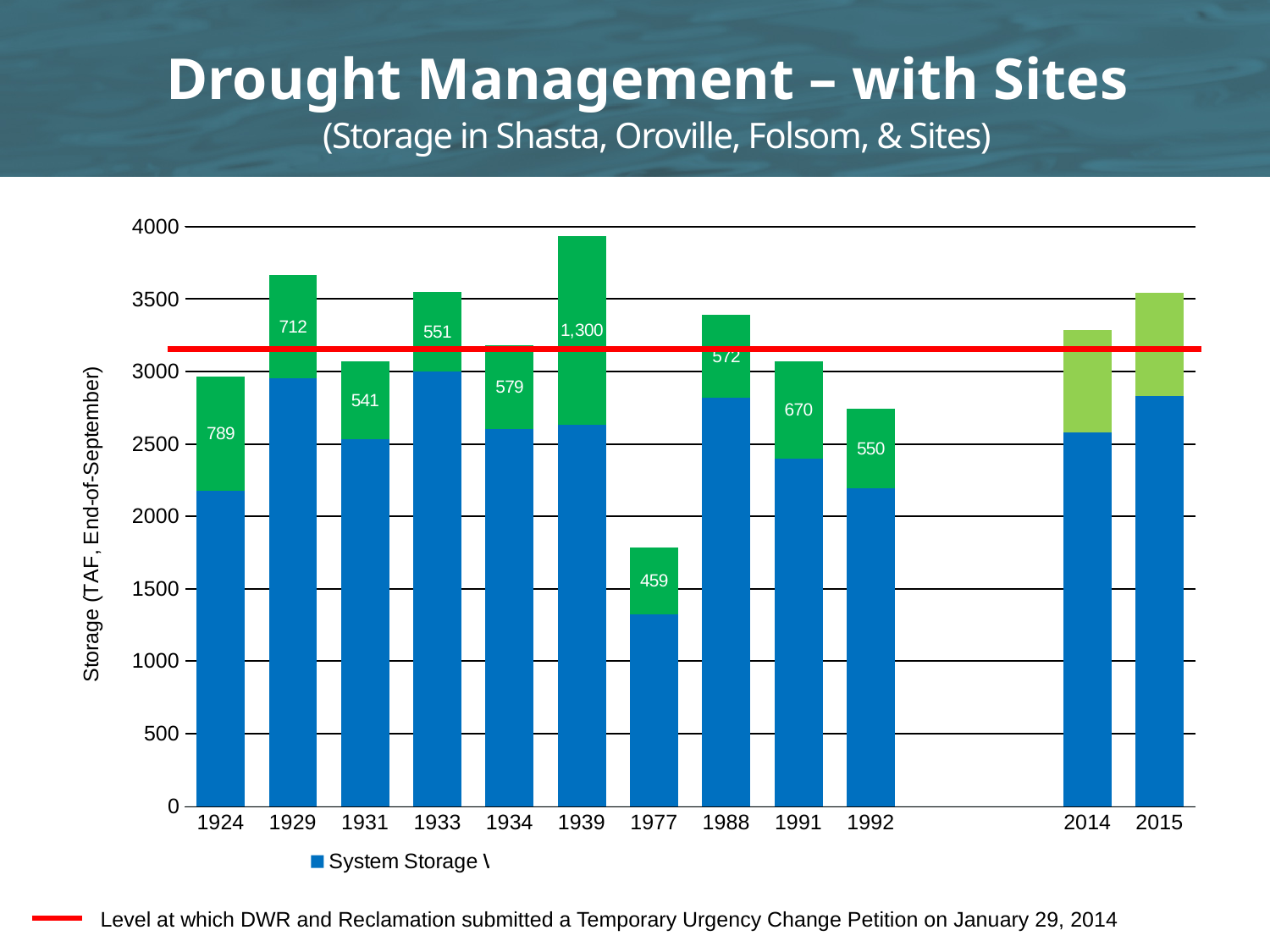
How many years are shown on the x axis? 12 Is the blue System Storage value for 1977 greater or less than 1500? less What is the value printed on the green segment for 1991? 670 What is the label on the y axis? Storage (TAF, End-of-September) What is the value printed on the green segment for 1924? 789 Which is larger, the green segment value for 1929 or for 1991? 1929 Which year has the largest labelled green segment? 1939 Which year has the smallest labelled green segment? 1977 What is the value printed on the green segment for 1939? 1,300 What is the difference between the green segment values for 1939 and 1977? 841 What kind of chart is shown on the slide? bar chart Is the total bar height for 1939 greater or less than 3500? greater